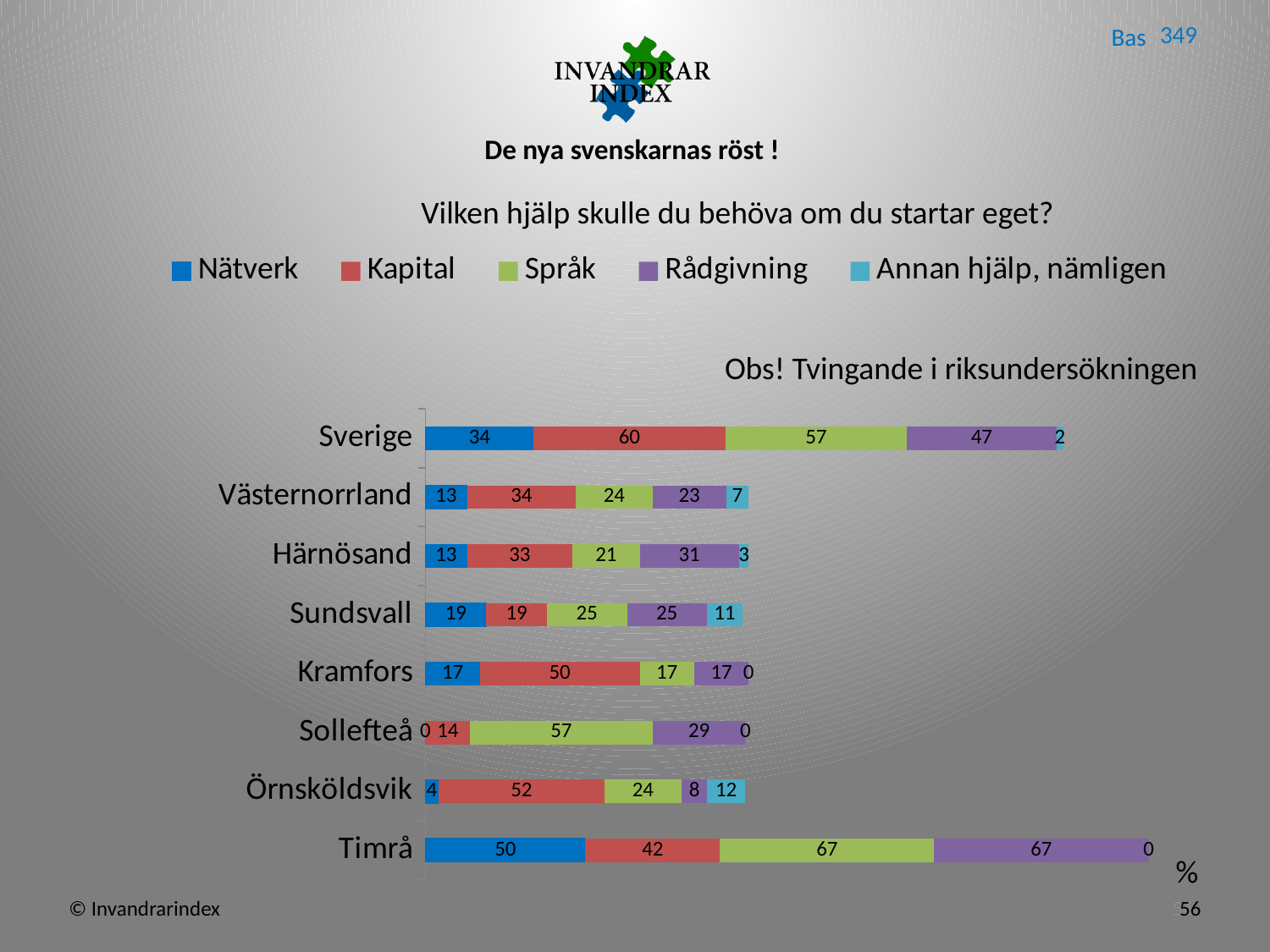
Which is larger: the Rådgivning value for Härnösand or the Rådgivning value for Västernorrland? Härnösand What is the title of the chart? Vilken hjälp skulle du behöva om du startar eget? What is the Språk value for Sollefteå? 57 How many series does the legend list? 5 What is the total of the stacked bar for Timrå? 226 What is the difference between the Kapital value for Kramfors and the Kapital value for Sundsvall? 31 How many categories (regions) are plotted on the chart? 8 What is the Annan hjälp, nämligen value for Örnsköldsvik? 12 What kind of chart is shown on the slide? stacked bar chart Which category has the highest Nätverk value? Timrå Which category has the lowest Kapital value? Sollefteå What is the Kapital value for Sverige? 60